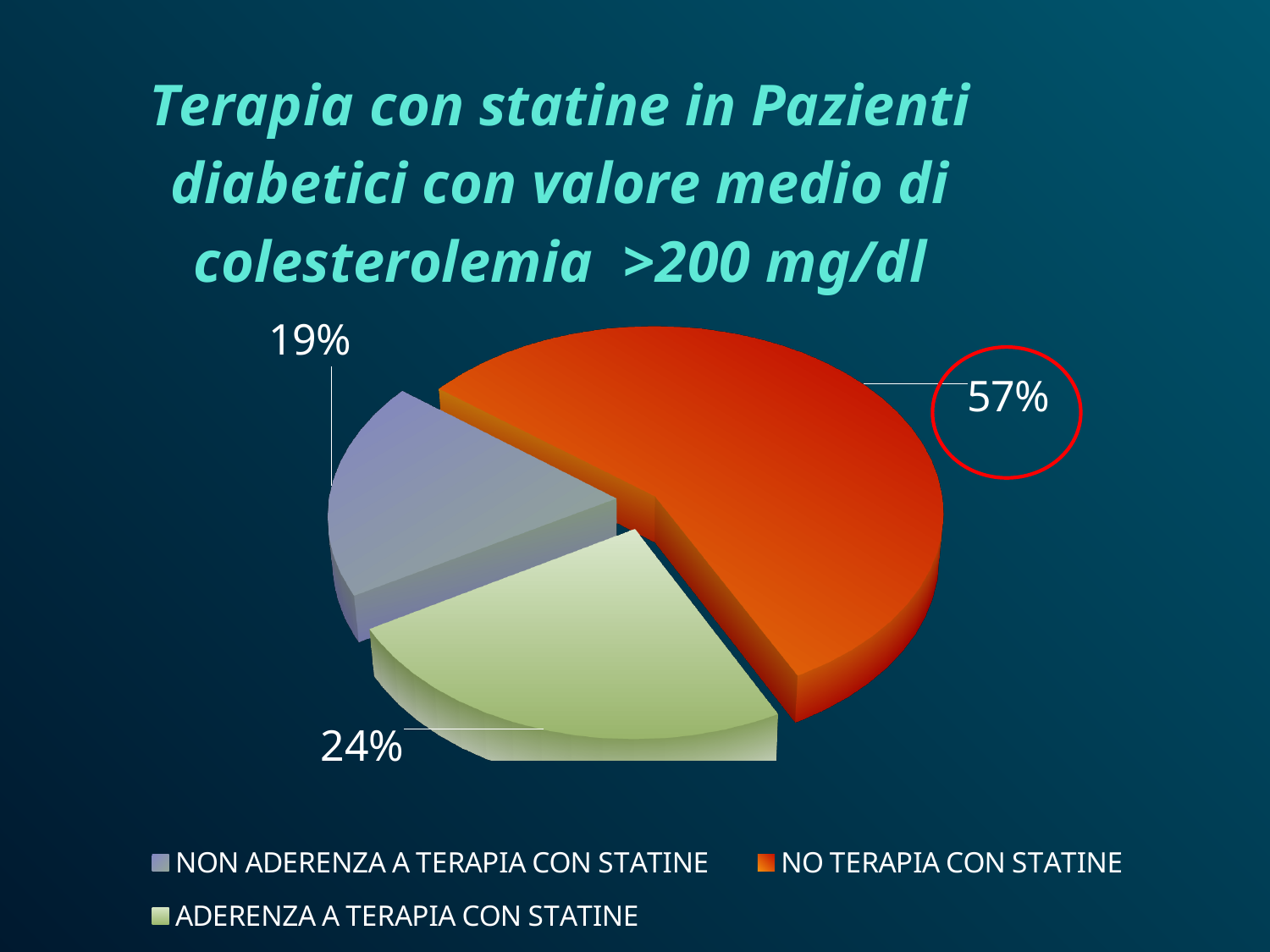
What percentage of patients is shown for ADERENZA A TERAPIA CON STATINE? 24% How many slices does the pie chart have? 3 What percentage of patients is shown for NO TERAPIA CON STATINE? 57% What colour is the slice for NO TERAPIA CON STATINE? orange-red Which slice of the pie is highlighted with a red circle around its label? 57% What percentage of patients is shown for NON ADERENZA A TERAPIA CON STATINE? 19% Which category has the smallest slice of the pie? NON ADERENZA A TERAPIA CON STATINE What is the difference in percentage points between NO TERAPIA CON STATINE and ADERENZA A TERAPIA CON STATINE? 33 What kind of chart is shown on the slide? pie chart Which is larger, the slice for ADERENZA A TERAPIA CON STATINE or the slice for NON ADERENZA A TERAPIA CON STATINE? ADERENZA A TERAPIA CON STATINE What is the difference in percentage points between ADERENZA A TERAPIA CON STATINE and NON ADERENZA A TERAPIA CON STATINE? 5 Which category has the largest slice of the pie? NO TERAPIA CON STATINE